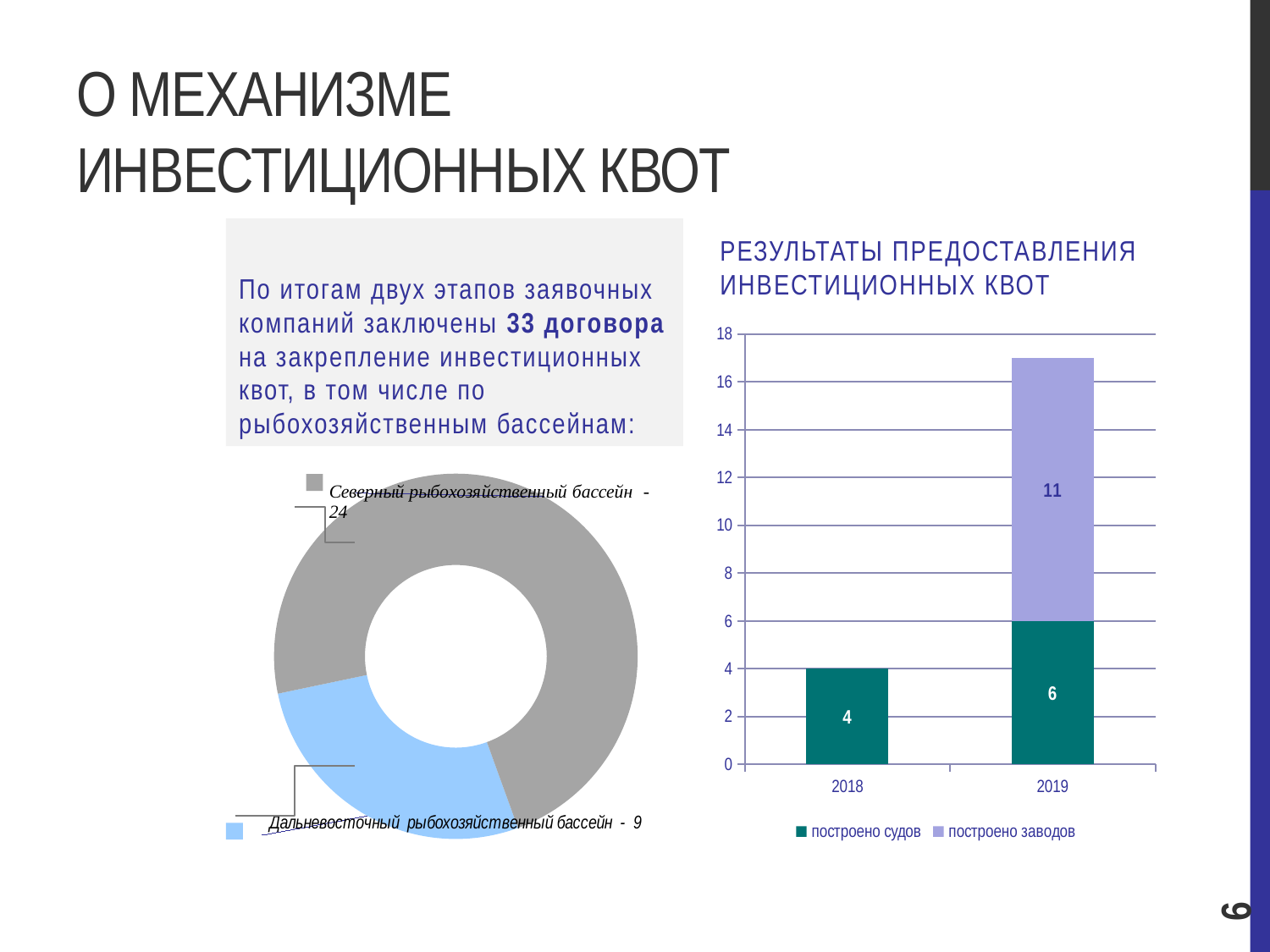
In the donut chart on the left of the slide, which basin has the larger slice? Северный рыбохозяйственный бассейн In the bar chart titled 'РЕЗУЛЬТАТЫ ПРЕДОСТАВЛЕНИЯ ИНВЕСТИЦИОННЫХ КВОТ', what is the value of 'построено судов' for 2019? 6 In the bar chart titled 'РЕЗУЛЬТАТЫ ПРЕДОСТАВЛЕНИЯ ИНВЕСТИЦИОННЫХ КВОТ', by how much did 'построено судов' increase from 2018 to 2019? 2 In the bar chart titled 'РЕЗУЛЬТАТЫ ПРЕДОСТАВЛЕНИЯ ИНВЕСТИЦИОННЫХ КВОТ', what is the total height of the stacked bar for 2019? 17 In the bar chart titled 'РЕЗУЛЬТАТЫ ПРЕДОСТАВЛЕНИЯ ИНВЕСТИЦИОННЫХ КВОТ', how many series does the legend list? 2 In the bar chart titled 'РЕЗУЛЬТАТЫ ПРЕДОСТАВЛЕНИЯ ИНВЕСТИЦИОННЫХ КВОТ', how many years are shown on the x axis? 2 In the bar chart titled 'РЕЗУЛЬТАТЫ ПРЕДОСТАВЛЕНИЯ ИНВЕСТИЦИОННЫХ КВОТ', what is the value of 'построено заводов' for 2019? 11 In the donut chart on the left of the slide, what value is given for 'Дальневосточный рыбохозяйственный бассейн'? 9 What kind of chart is the one on the right of the slide, titled 'РЕЗУЛЬТАТЫ ПРЕДОСТАВЛЕНИЯ ИНВЕСТИЦИОННЫХ КВОТ'? Stacked bar chart In the donut chart on the left of the slide, what value is given for 'Северный рыбохозяйственный бассейн'? 24 In the bar chart titled 'РЕЗУЛЬТАТЫ ПРЕДОСТАВЛЕНИЯ ИНВЕСТИЦИОННЫХ КВОТ', how many 'построено судов' are shown for 2018? 4 In the bar chart titled 'РЕЗУЛЬТАТЫ ПРЕДОСТАВЛЕНИЯ ИНВЕСТИЦИОННЫХ КВОТ', which year has the taller total bar, 2018 or 2019? 2019